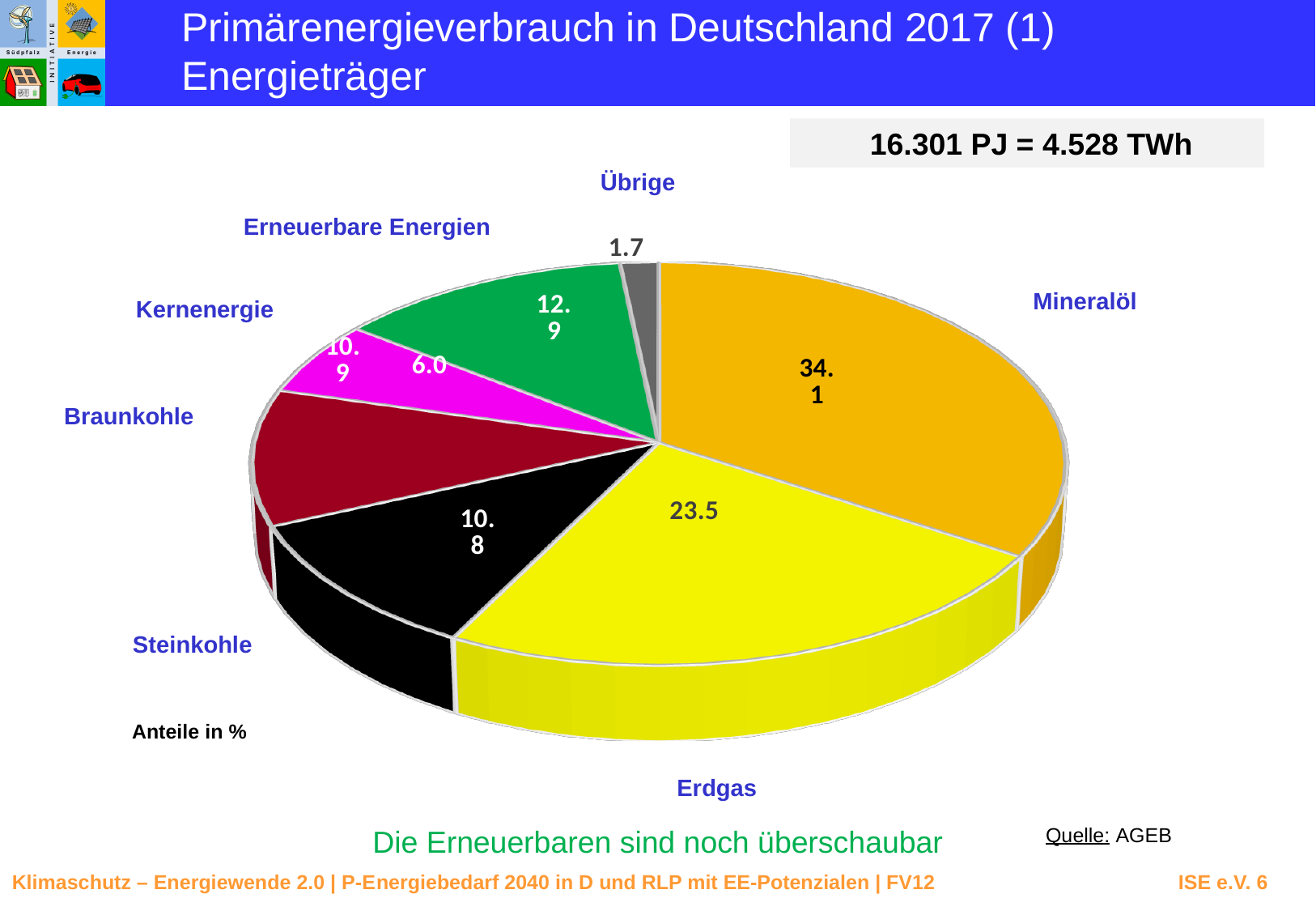
What share does Mineralöl have in the pie chart? 34.1 What kind of chart is shown on the slide? pie chart What share does Steinkohle have in the pie chart? 10.8 How many slices does the pie chart have? 7 What share do Erneuerbare Energien have in the pie chart? 12.9 What share does Erdgas have in the pie chart? 23.5 Which energy source has the smallest slice of the pie chart? Übrige What total primary energy consumption is stated in the box above the pie chart? 16.301 PJ = 4.528 TWh Which energy source has the largest slice of the pie chart? Mineralöl What share does Übrige have in the pie chart? 1.7 Which has the larger share, Erdgas or Erneuerbare Energien? Erdgas What is the difference in percentage points between the Mineralöl and Erdgas shares? 10.6